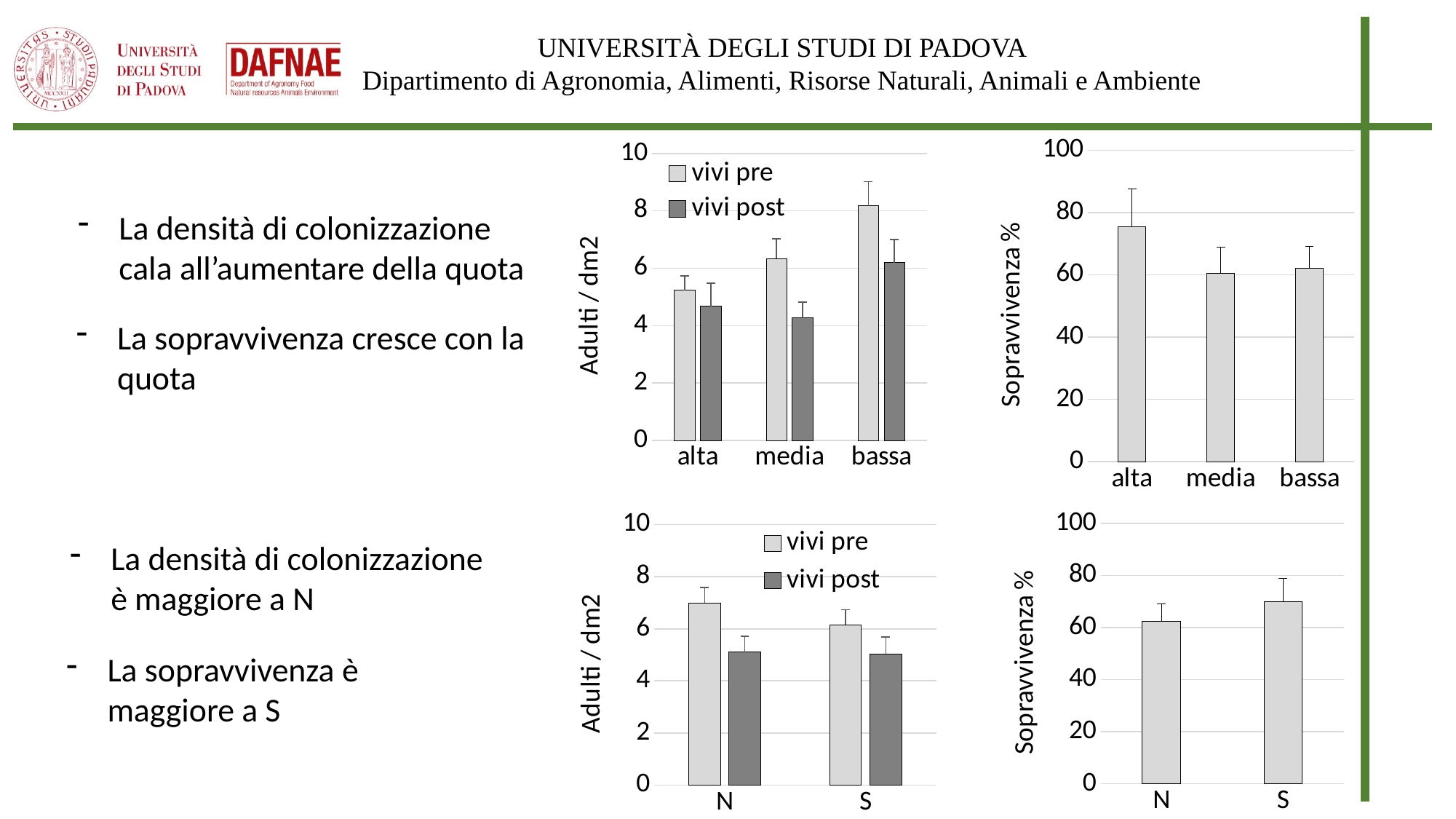
In the top-left chart (Adulti / dm2 by alta, media, bassa), which category has the highest 'vivi pre' value? bassa In the bottom-left chart (Adulti / dm2 by N and S), which is larger, the 'vivi pre' value for N or for S? N What kind of chart is the bottom-right chart (Sopravvivenza % by N and S)? bar chart In the top-right chart (Sopravvivenza % by alta, media, bassa), is the value for alta greater or less than 60? greater In the bottom-right chart (Sopravvivenza % by N and S), is the value for N greater or less than 80? less In the top-right chart (Sopravvivenza % by alta, media, bassa), which category has the highest survival? alta In the top-left chart (Adulti / dm2 by alta, media, bassa), which category has the lowest 'vivi post' value? media In the bottom-left chart (Adulti / dm2 by N and S), is the 'vivi post' value for N greater or less than 6? less In the top-right chart (Sopravvivenza % by alta, media, bassa), how many categories are shown on the x axis? 3 In the top-left chart (Adulti / dm2 by alta, media, bassa), how many series does the legend list? 2 In the bottom-right chart (Sopravvivenza % by N and S), which category has the higher survival? S